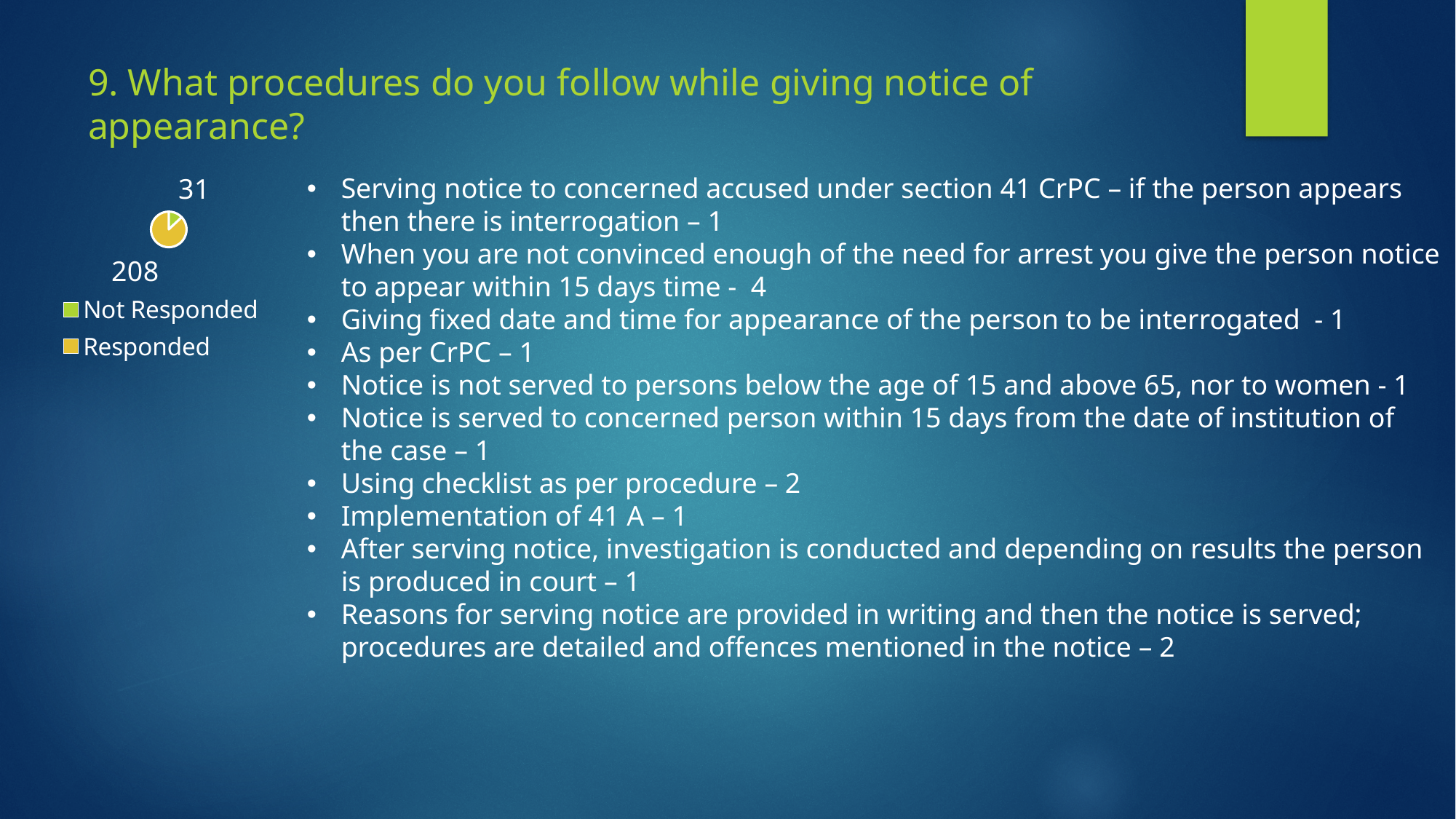
What type of chart is shown on the slide? pie chart Which is larger, Responded or Not Responded? Responded What is the value for Not Responded in the pie chart? 31 What is the value for Responded in the pie chart? 208 How many slices does the pie chart have? 2 Which colour represents Responded in the pie chart? yellow How many entries does the legend list? 2 What is the total of the two values shown in the pie chart? 239 What is the difference between the Responded and Not Responded values? 177 Which category has the largest slice in the pie chart? Responded Which colour represents Not Responded in the pie chart? green Which category has the smallest slice in the pie chart? Not Responded